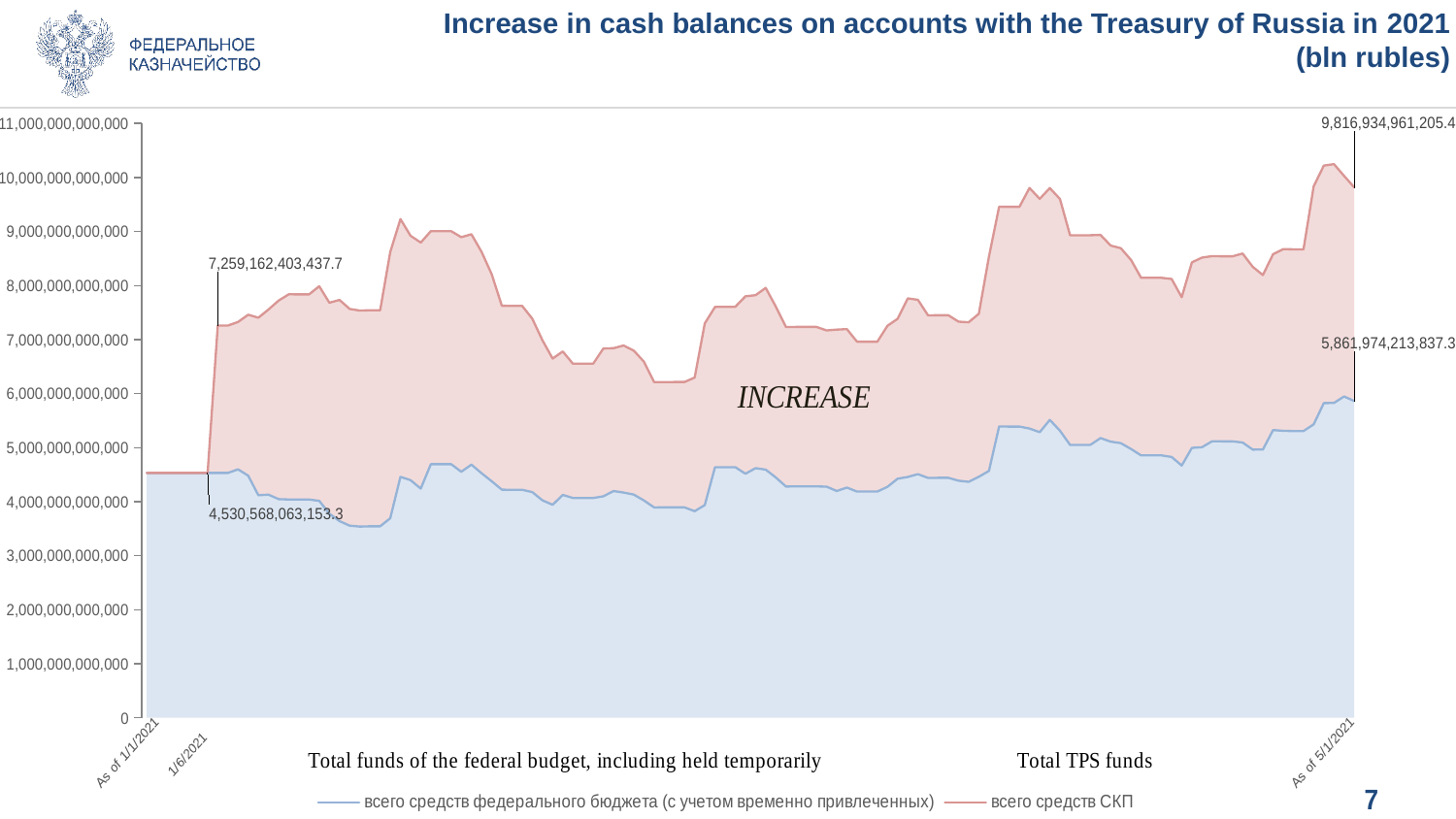
What is the value of Total funds of the federal budget, including held temporarily, as of 5/1/2021? 5,861,974,213,837.3 What word is written in the middle of the chart between the two series? INCREASE By how much did Total TPS funds increase from the 1/6/2021 label to the 5/1/2021 label? 2,557,772,557,767.7 What kind of chart is shown on the slide? Area chart How many series does the chart legend list? 2 Is the value of Total funds of the federal budget as of 1/1/2021 greater or less than 5,000,000,000,000? less As of 5/1/2021, how much larger is Total TPS funds than Total funds of the federal budget? 3,954,960,747,368.1 On 1/6/2021, what is the difference between Total TPS funds and Total funds of the federal budget? 2,728,594,340,284.4 As of 5/1/2021, which series is larger: Total TPS funds or Total funds of the federal budget? Total TPS funds What is the labelled value of Total TPS funds on 1/6/2021? 7,259,162,403,437.7 What is the labelled value of Total funds of the federal budget on 1/6/2021? 4,530,568,063,153.3 What is the value of Total TPS funds as of 5/1/2021? 9,816,934,961,205.4